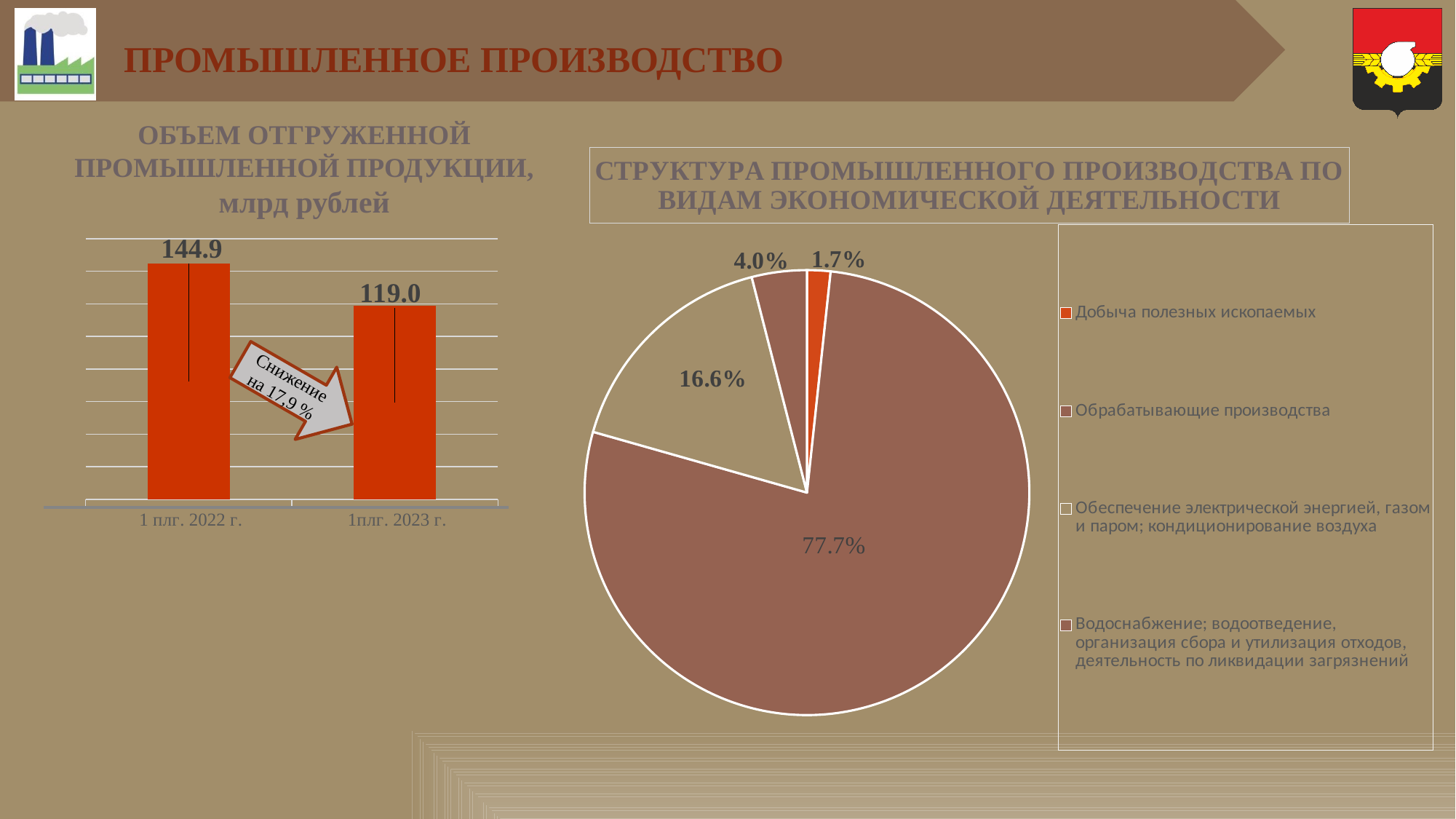
In the bar chart on the left, do the values rise or fall from 1 плг. 2022 г. to 1плг. 2023 г.? fall What type of chart is 'СТРУКТУРА ПРОМЫШЛЕННОГО ПРОИЗВОДСТВА ПО ВИДАМ ЭКОНОМИЧЕСКОЙ ДЕЯТЕЛЬНОСТИ'? pie chart In the pie chart, what share does 'Обрабатывающие производства' have? 77.7% In the bar chart 'ОБЪЕМ ОТГРУЖЕННОЙ ПРОМЫШЛЕННОЙ ПРОДУКЦИИ, млрд рублей', what is the value for 1плг. 2023 г.? 119.0 In the pie chart, which category has the smallest slice? Добыча полезных ископаемых In the pie chart, what share does 'Добыча полезных ископаемых' have? 1.7% How many categories does the legend of the pie chart list? 4 How many bars are shown in the chart on the left? 2 In the bar chart on the left, which period has the higher value? 1 плг. 2022 г. In the pie chart, which is larger: 'Обеспечение электрической энергией, газом и паром; кондиционирование воздуха' or 'Водоснабжение; водоотведение, организация сбора и утилизация отходов, деятельность по ликвидации загрязнений'? Обеспечение электрической энергией, газом и паром; кондиционирование воздуха In the bar chart 'ОБЪЕМ ОТГРУЖЕННОЙ ПРОМЫШЛЕННОЙ ПРОДУКЦИИ, млрд рублей', what is the value for 1 плг. 2022 г.? 144.9 In the bar chart on the left, what is the difference between the 2022 and 2023 values? 25.9